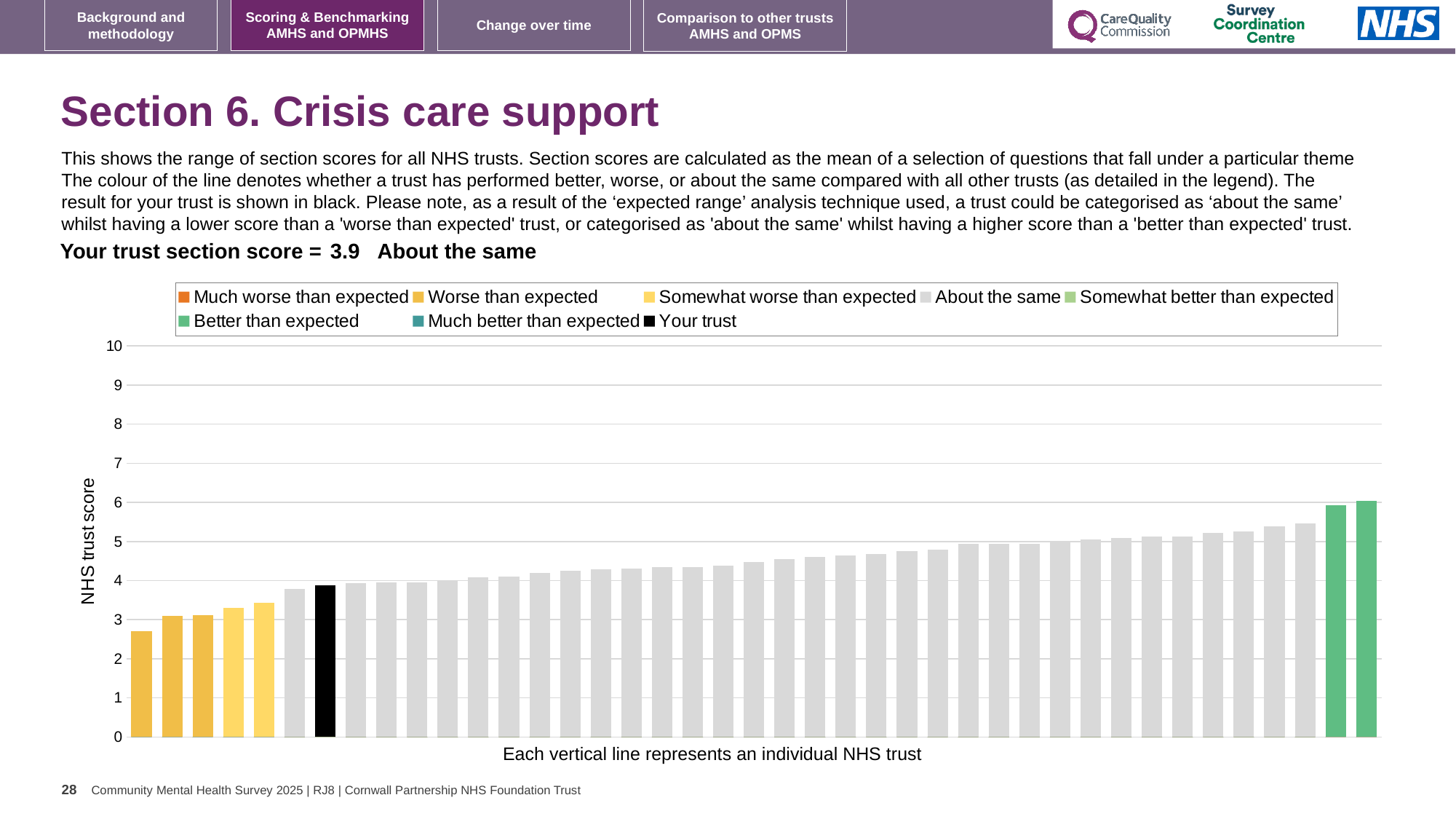
Which category is your trust placed in for this section? About the same What kind of chart is shown on the slide? bar chart Is the value of the leftmost bar greater or less than 3? less Is the value of the rightmost bar greater or less than 5? greater Is the value of the black bar (your trust) greater or less than 3? greater How many entries does the chart legend list? 8 Which bar is the highest in the chart: the leftmost or the rightmost? rightmost What is the label on the vertical axis of the chart? NHS trust score How many bars are coloured green (better than expected) in the chart? 2 What is the section score for your trust shown on the slide? 3.9 Do the bar values rise or fall from left to right across the chart? rise